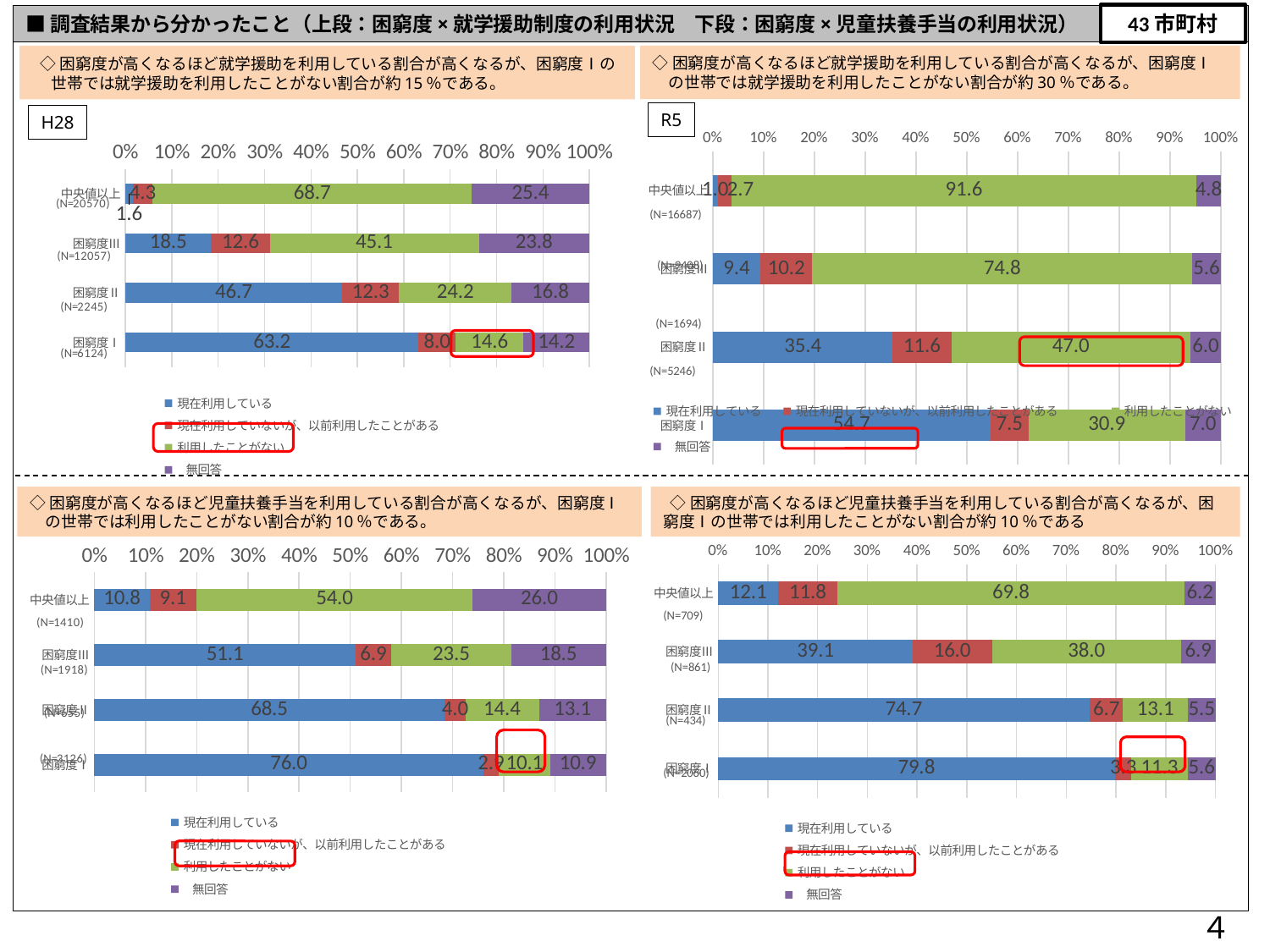
In the top-left chart (H28, upper row), what is the value of 現在利用している for 困窮度Ⅰ? 63.2 In the bottom-left chart (H28, lower row), what is the value of 現在利用している for 困窮度Ⅰ? 76.0 In the bottom-left chart (H28, lower row), what is the difference between the 現在利用している values for 困窮度Ⅰ and 中央値以上? 65.2 In the bottom-right chart (R5, lower row), which category has the lowest value for 現在利用している? 中央値以上 How many categories are plotted in the top-right chart (R5, upper row)? 4 How many series does the legend of the top-left chart (H28, upper row) list? 4 What kind of chart is the bottom-left chart (H28, lower row)? Stacked bar chart In the top-right chart (R5, upper row), which category has the highest value for 現在利用している? 困窮度Ⅰ In the bottom-right chart (R5, lower row), which is larger for 困窮度Ⅲ: 現在利用している or 利用したことがない? 現在利用している In the top-right chart (R5, upper row), what is the value of 利用したことがない for 中央値以上? 91.6 In the top-left chart (H28, upper row), what is the value of 利用したことがない for 困窮度Ⅰ? 14.6 In the bottom-right chart (R5, lower row), what is the value of 利用したことがない for 困窮度Ⅰ? 11.3